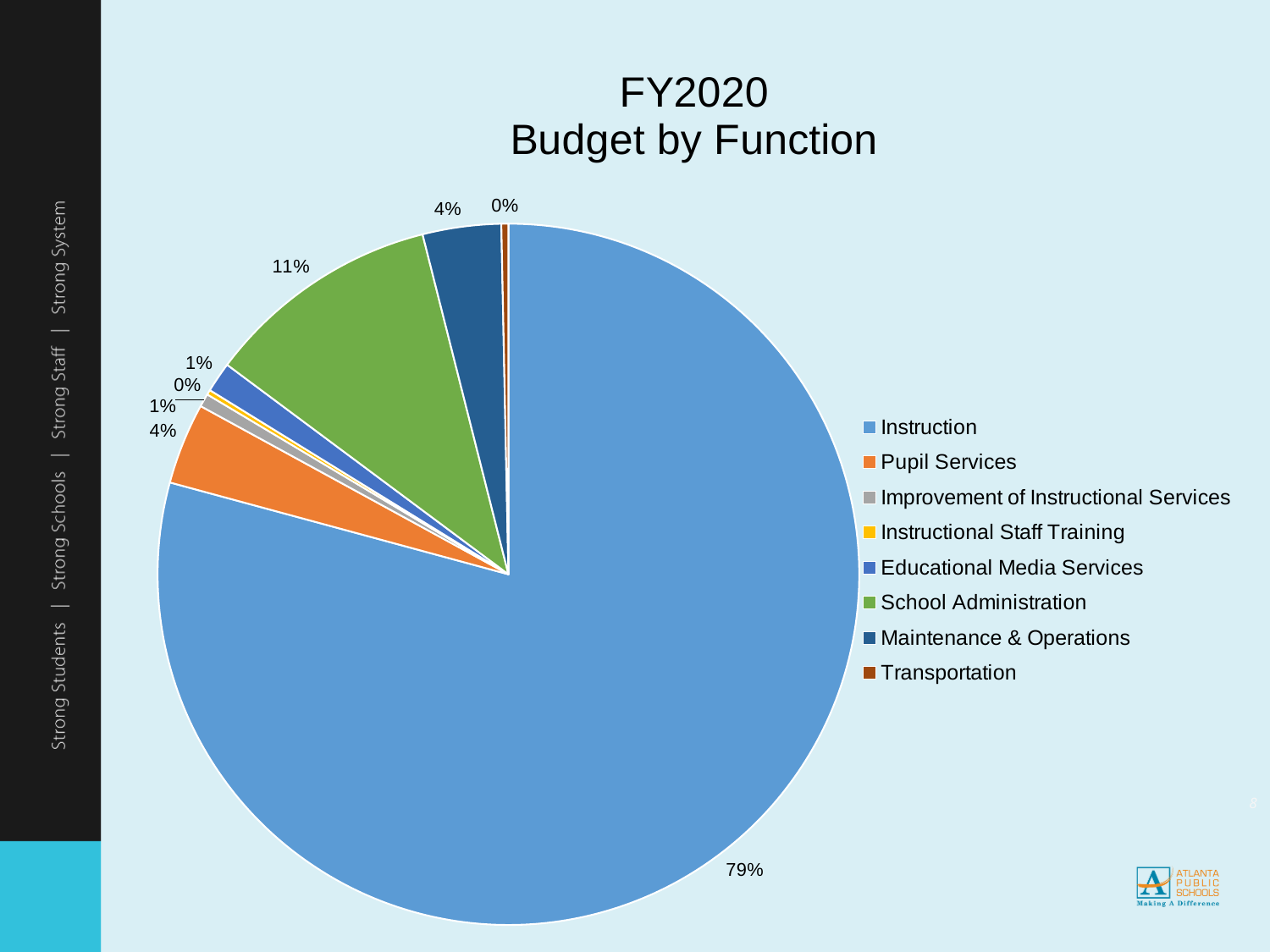
What share of the budget goes to Educational Media Services? 1% What type of chart is shown on the slide? Pie chart Which function receives the largest share of the FY2020 budget? Instruction What percentage of the budget is for Pupil Services? 4% What share of the budget is allocated to School Administration? 11% What is the title of the chart? FY2020 Budget by Function What colour is the slice for School Administration? Green How many functions are listed in the chart legend? 8 Which is larger, the share for School Administration or the share for Pupil Services? School Administration What is the difference in percentage points between the Instruction share and the School Administration share? 68